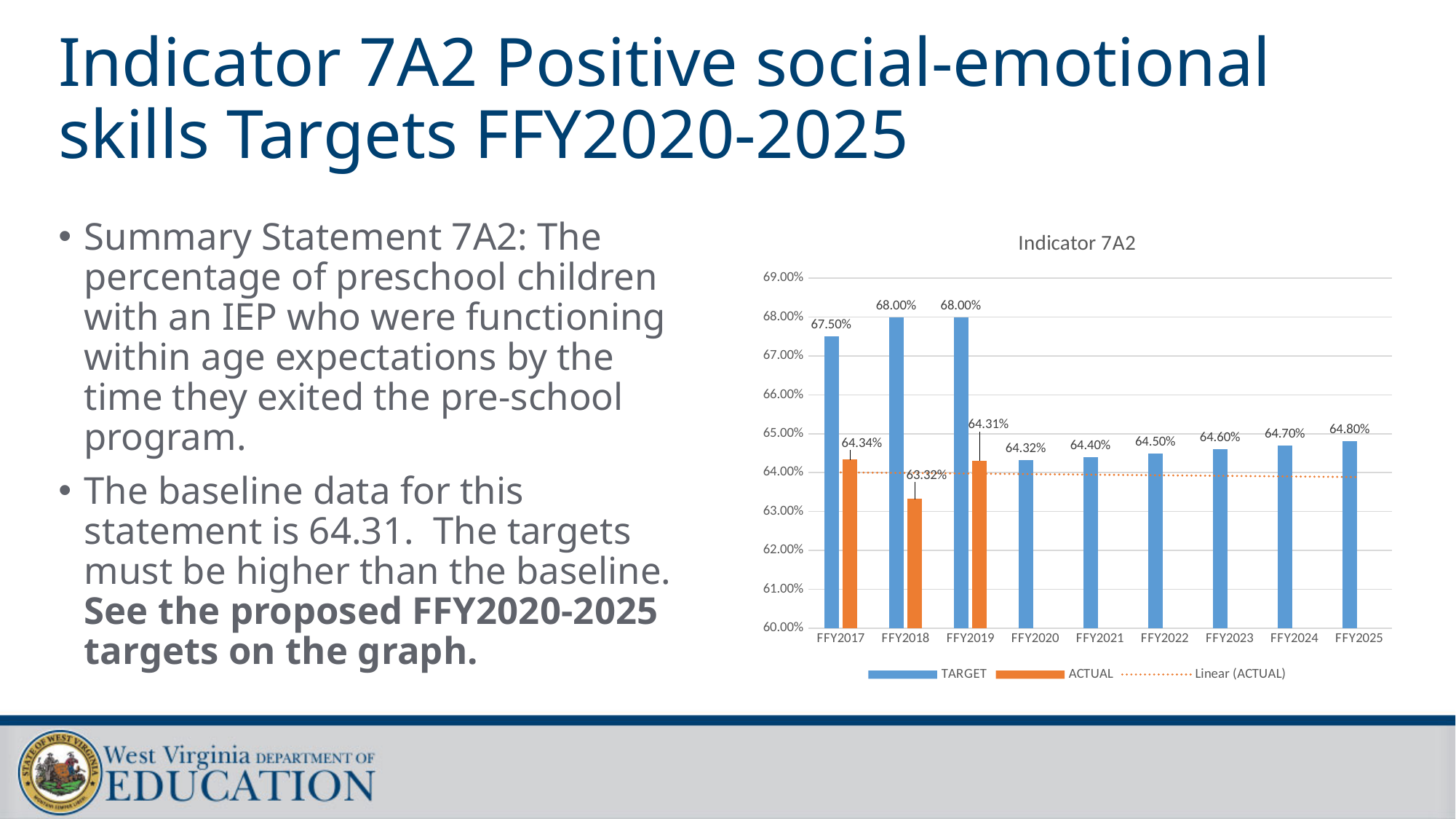
What is the ACTUAL value for FFY2019? 64.31% Do the TARGET values rise or fall from FFY2020 to FFY2025? Rise How many entries does the legend list? 3 What is the ACTUAL value for FFY2018? 63.32% What is the difference between the TARGET and ACTUAL values for FFY2018? 4.68% What is the TARGET value for FFY2025? 64.80% Which year has the lowest TARGET value? FFY2020 What kind of chart is shown? Bar chart Which year has the lowest ACTUAL value? FFY2018 How many years are shown on the x axis? 9 Which is larger, the ACTUAL value for FFY2017 or the ACTUAL value for FFY2019? FFY2017 What is the TARGET value for FFY2017? 67.50%